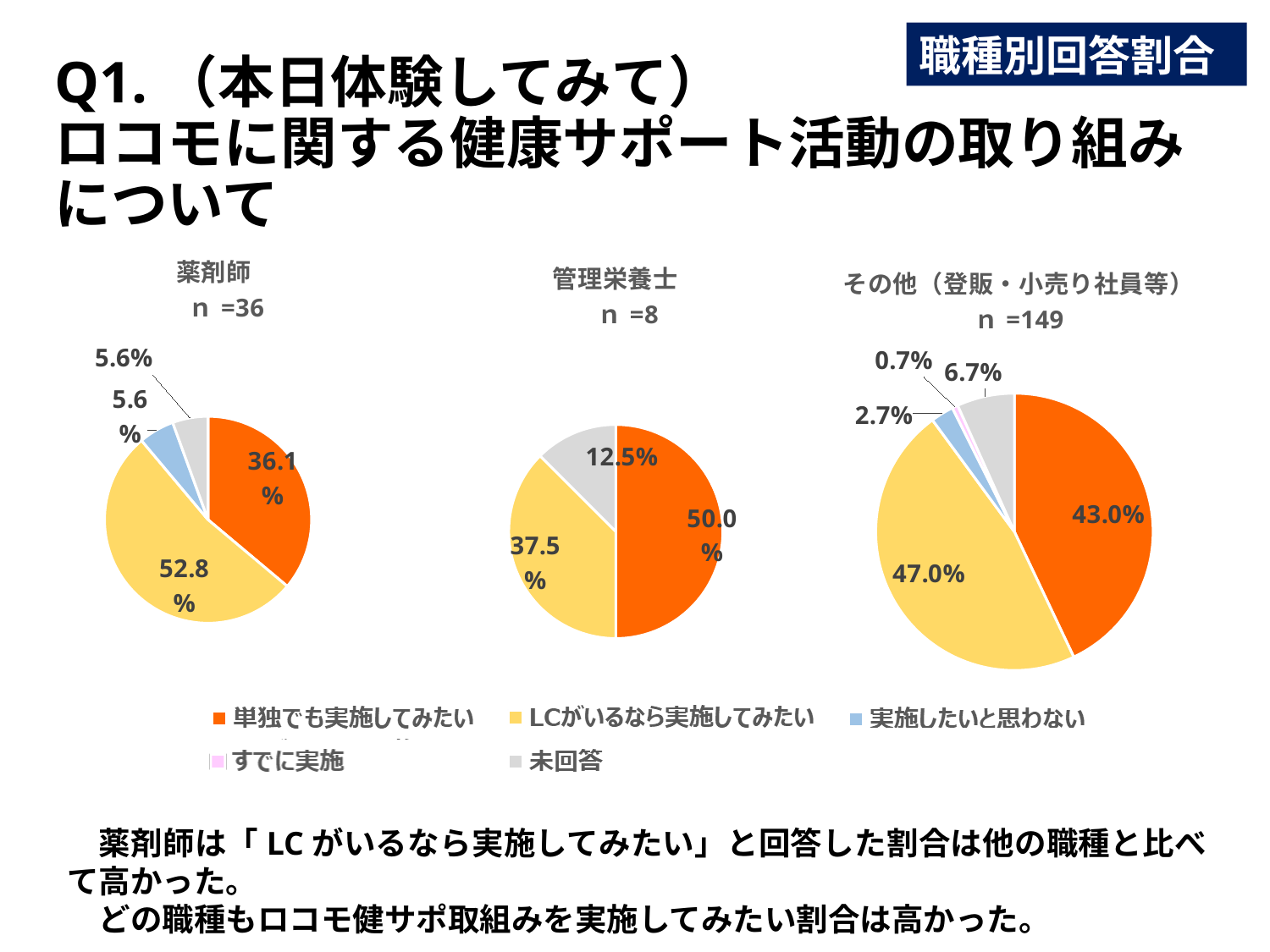
In the その他（登販・小売り社員等） pie chart, which response has the smallest share? すでに実施 In the 管理栄養士 pie chart, what share of respondents answered 「単独でも実施してみたい」? 50.0% In the 薬剤師 pie chart, which response has the largest share? LCがいるなら実施してみたい How many response categories does the legend list? 5 In the その他（登販・小売り社員等） pie chart, what share of respondents answered 「すでに実施」? 0.7% What kind of chart is used for the 薬剤師 data? Pie chart In the 薬剤師 pie chart, what share of respondents answered 「LCがいるなら実施してみたい」? 52.8% How many slices does the 管理栄養士 pie chart have? 3 In the 管理栄養士 pie chart, what is the difference between the shares for 「単独でも実施してみたい」 and 「LCがいるなら実施してみたい」? 12.5% In the その他（登販・小売り社員等） pie chart, what share of respondents answered 「未回答」? 6.7% What is the sample size (n) shown for the その他（登販・小売り社員等） pie chart? 149 In the その他（登販・小売り社員等） pie chart, which is larger: the share for 「単独でも実施してみたい」 or the share for 「LCがいるなら実施してみたい」? LCがいるなら実施してみたい